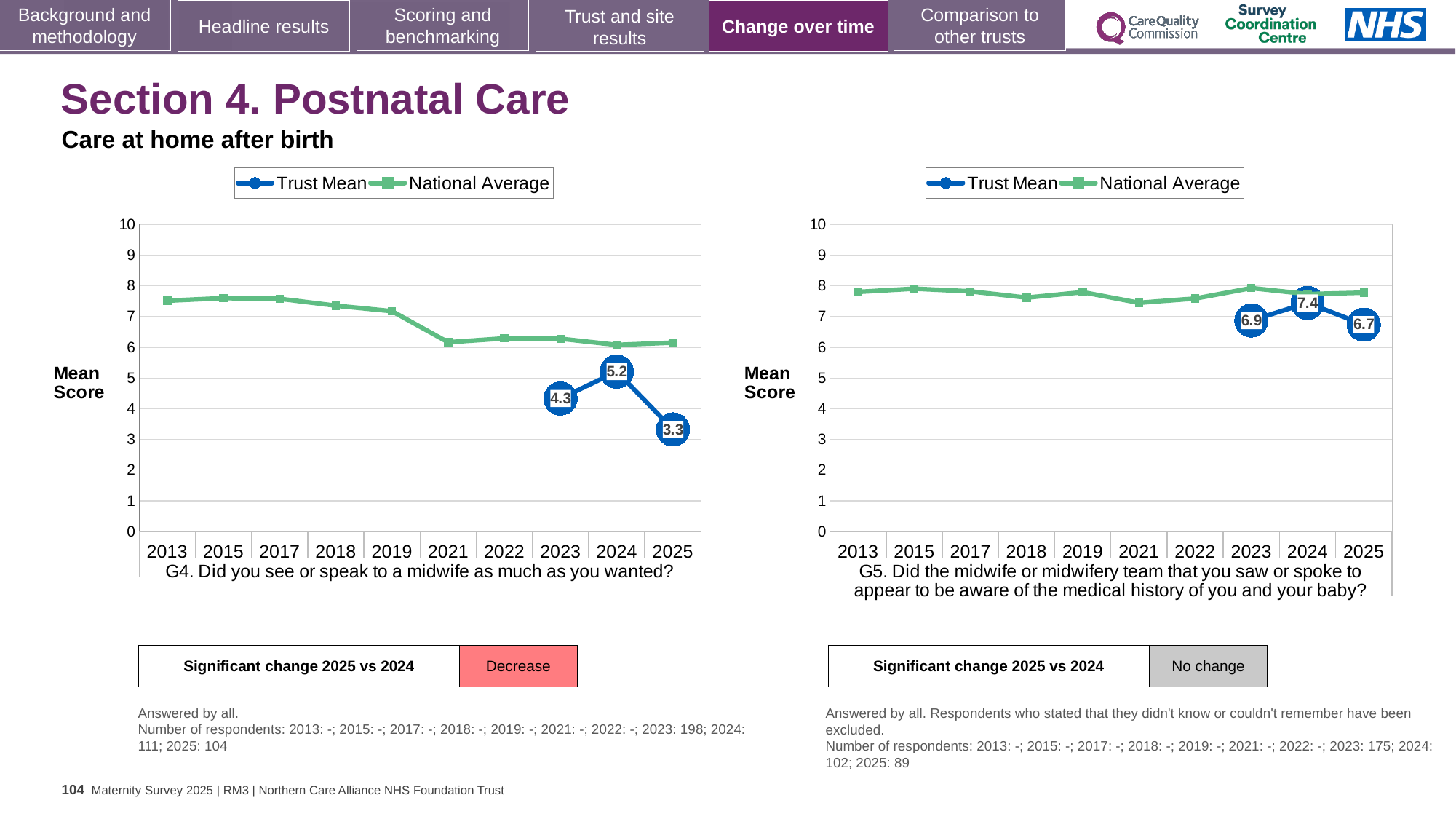
In the G5 chart (right), which year has the highest Trust Mean? 2024 In the G4 chart (left), what is the Trust Mean for 2024? 5.2 How many series does the legend of the G5 chart (right) list? 2 In the G4 chart (left), what is the difference between the Trust Mean for 2024 and 2025? 1.9 In the G5 chart (right), what is the difference between the Trust Mean for 2024 and 2023? 0.5 In the G4 chart (left), is the National Average for 2013 greater or less than 7? greater In the G4 chart (left), which year has the lowest Trust Mean? 2025 In the G5 chart (right), what is the Trust Mean for 2023? 6.9 In the G5 chart (right), what is the Trust Mean for 2025? 6.7 What kind of chart is the G4 chart (left)? Line chart In the G4 chart (left), what is the Trust Mean for 2025? 3.3 In the G4 chart (left), which year has the highest Trust Mean? 2024